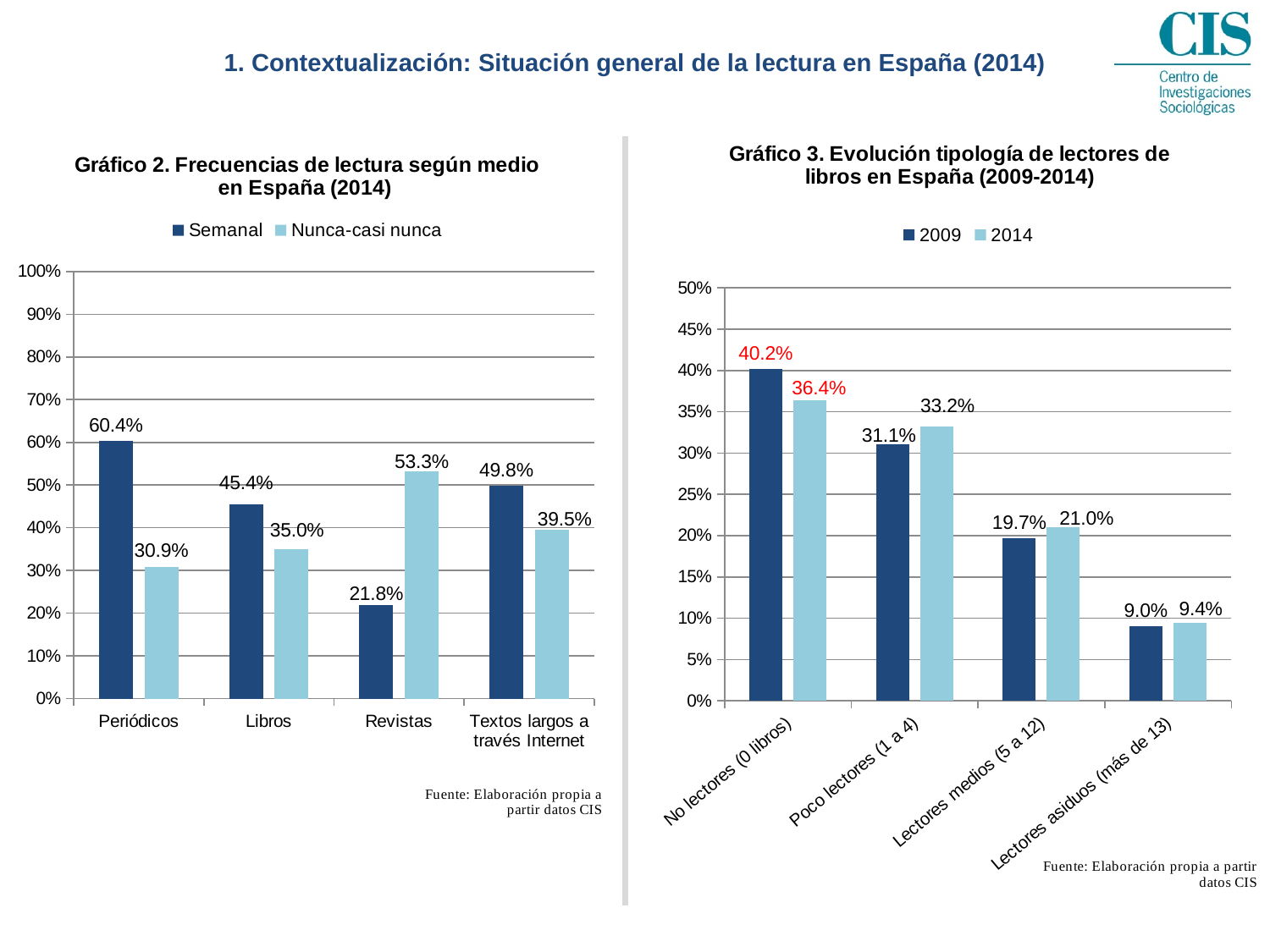
What type of chart is Gráfico 3? Bar chart In Gráfico 2, how many series does the legend list? 2 In Gráfico 2, which category has the highest Semanal value? Periódicos In Gráfico 3, which category has the highest 2014 value? No lectores (0 libros) In Gráfico 2, which category has the lowest Semanal value? Revistas In Gráfico 2, what is the Nunca-casi nunca value for Revistas? 53.3% In Gráfico 2, what is the Semanal value for Periódicos? 60.4% In Gráfico 3, what is the 2014 value for Lectores asiduos (más de 13)? 9.4% In Gráfico 3, is the 2009 value for Lectores medios (5 a 12) larger or smaller than the 2014 value? smaller In Gráfico 3, what is the 2009 value for Poco lectores (1 a 4)? 31.1% In Gráfico 3, what is the difference between the 2009 and 2014 values for No lectores (0 libros)? 3.8% In Gráfico 2, what is the difference between the Semanal and Nunca-casi nunca values for Libros? 10.4%